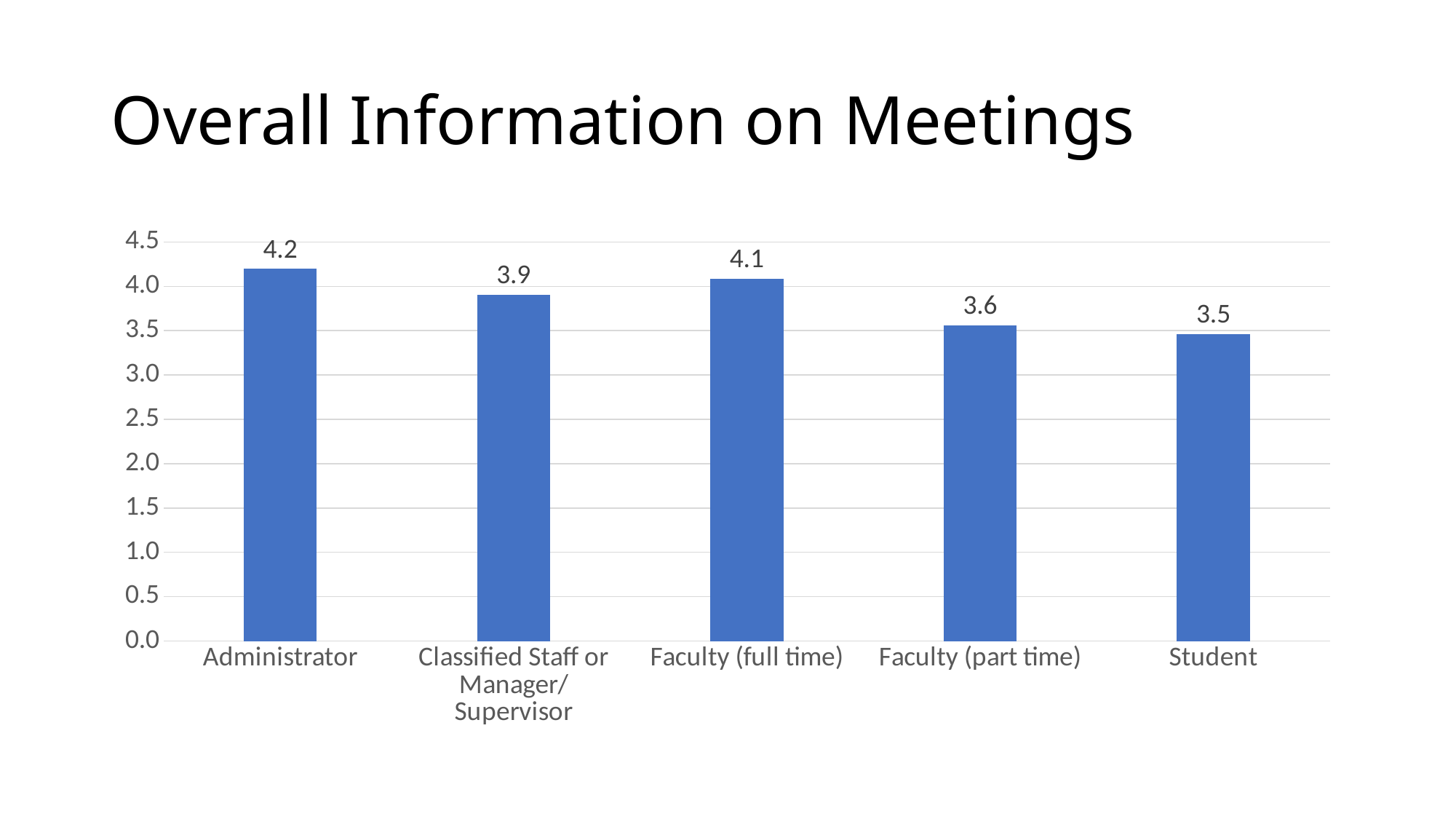
What is the value for Classified Staff or Manager/Supervisor? 3.9 Which category has the highest value? Administrator What is the value for Faculty (full time)? 4.1 How many categories are shown on the x axis? 5 Which category has the lowest value? Student Is the value for Faculty (part time) greater or less than 4.0? less What is the title of the slide? Overall Information on Meetings What is the difference between the values for Administrator and Student? 0.7 Which is larger, the value for Faculty (full time) or Faculty (part time)? Faculty (full time) What is the value for Administrator? 4.2 What is the value for Student? 3.5 What kind of chart is shown on the slide? bar chart